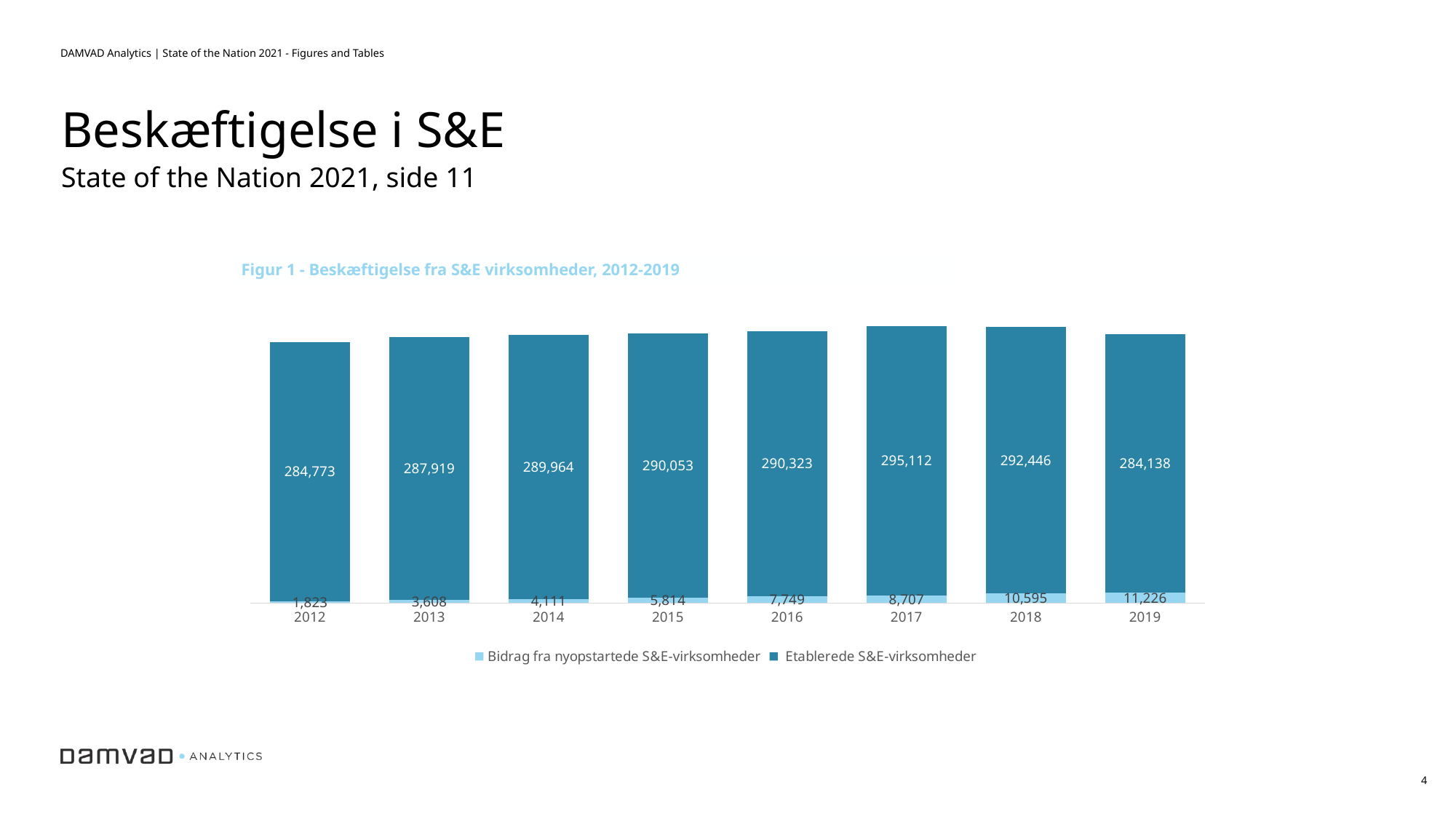
Does the value for Bidrag fra nyopstartede S&E-virksomheder rise or fall from 2012 to 2019? Rise What type of chart is shown on the slide? Stacked bar chart What is the value for Bidrag fra nyopstartede S&E-virksomheder in 2019? 11,226 Which year has the highest value for Etablerede S&E-virksomheder? 2017 What is the total of the stacked bar for 2019? 295,364 Which year has the lowest value for Bidrag fra nyopstartede S&E-virksomheder? 2012 Which is larger: the Etablerede S&E-virksomheder value in 2018 or in 2019? 2018 What is the difference between the Bidrag fra nyopstartede S&E-virksomheder values in 2019 and 2012? 9,403 How many series does the legend list? 2 How many years are shown on the x axis? 8 What is the value for Etablerede S&E-virksomheder in 2012? 284,773 What is the value for Etablerede S&E-virksomheder in 2017? 295,112